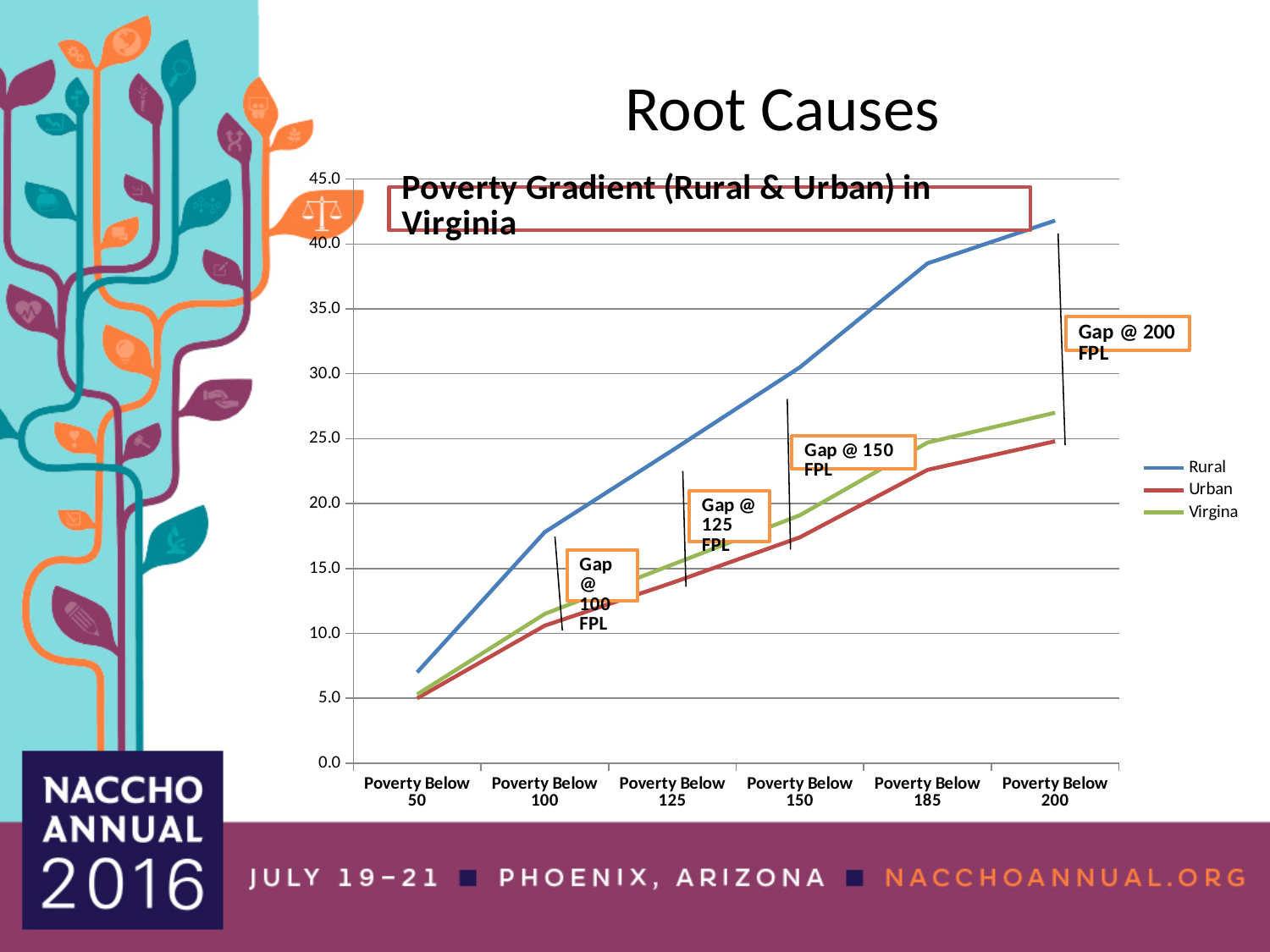
What is the title of the chart? Poverty Gradient (Rural & Urban) in Virginia Is the Urban value at Poverty Below 185 greater or less than 20.0? greater How many series does the legend list? 3 What kind of chart is shown on the slide? line chart Is the Rural value at Poverty Below 200 greater or less than 40.0? greater Is the Rural value at Poverty Below 185 greater or less than 35.0? greater Which series is drawn in blue? Rural How many categories are shown on the x axis? 6 Does the Rural series rise or fall from Poverty Below 50 to Poverty Below 200? rise Which series has the highest value at Poverty Below 200? Rural Which is larger at Poverty Below 200, the Rural value or the Urban value? Rural